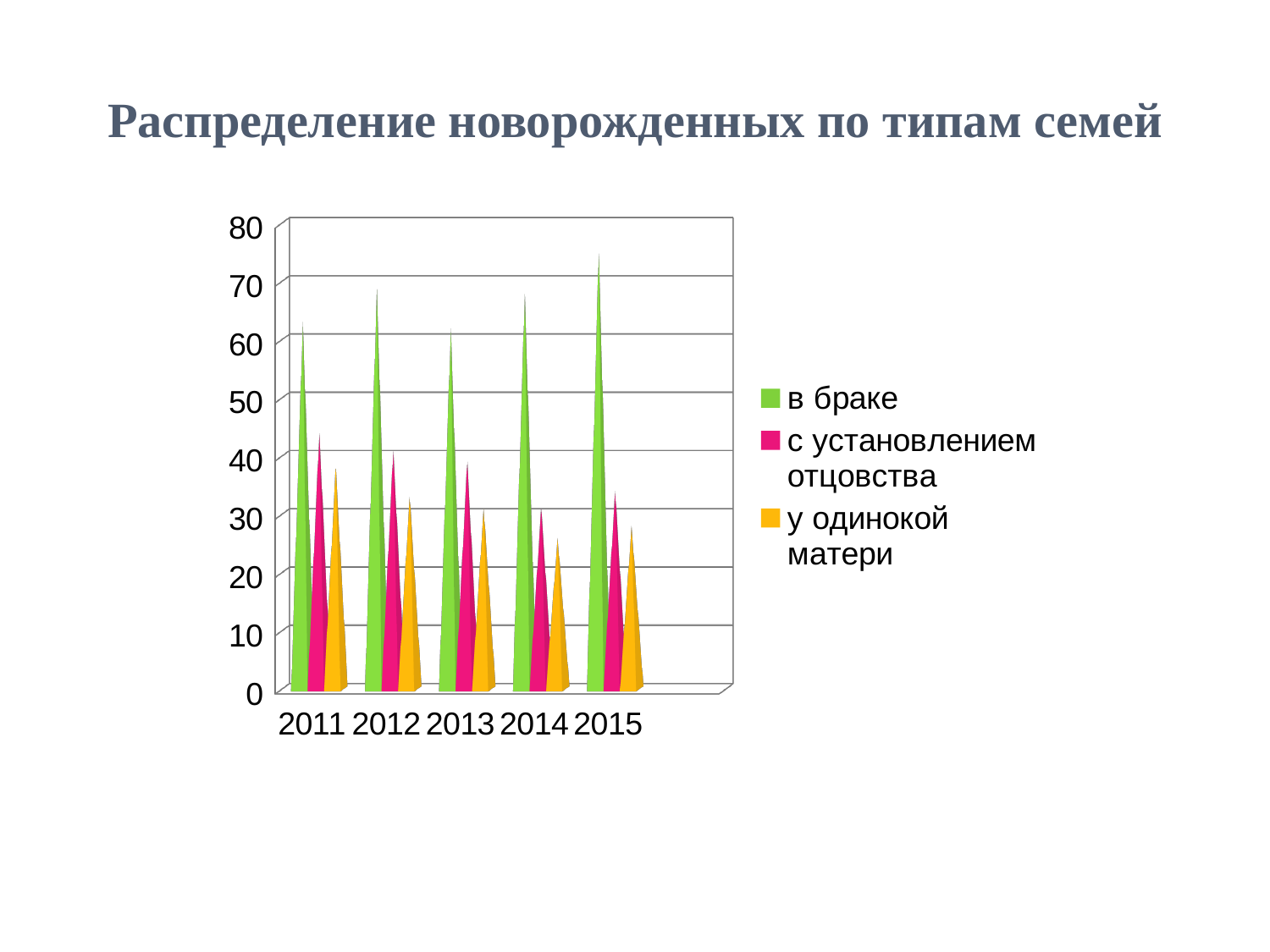
What is the title of the slide? Распределение новорожденных по типам семей What kind of chart is shown on the slide? bar chart Is the value for "у одинокой матери" in 2014 greater or less than 30? less In which year is the value for "в браке" the highest? 2015 Is the value for "в браке" in 2011 greater or less than 60? greater How many years are shown on the x axis? 5 In which year is the value for "с установлением отцовства" the highest? 2011 Which is larger for "в браке": the value in 2012 or in 2013? 2012 Does the value for "у одинокой матери" generally rise or fall from 2011 to 2014? fall How many series does the legend list? 3 Is the value for "с установлением отцовства" in 2011 greater or less than 40? greater